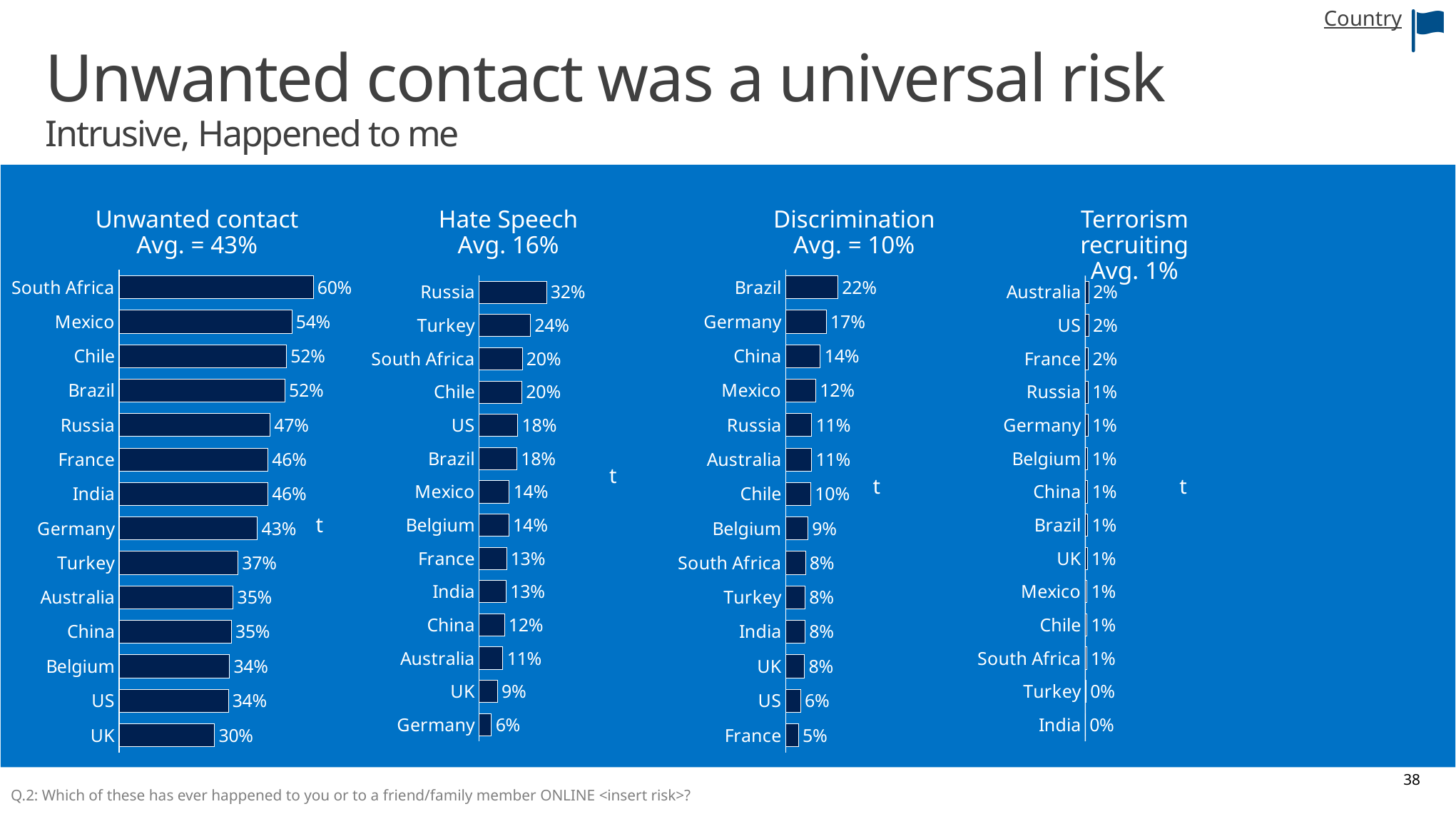
How many countries are shown in the Unwanted contact chart? 14 In the Hate Speech chart, which country has the highest value? Russia In the Discrimination chart, what is the difference between Brazil and China? 8% In the Unwanted contact chart, what is the value for South Africa? 60% In the Unwanted contact chart, which country has the lowest value? UK In the Terrorism recruiting chart, what is the value for Russia? 1% In the Discrimination chart, which country has the lowest value? France In the Hate Speech chart, what is the value for Belgium? 14% In the Hate Speech chart, which is larger, the value for Turkey or the value for US? Turkey In the Unwanted contact chart, what is the difference between Mexico and Germany? 11% In the Discrimination chart, what is the value for Germany? 17% What type of chart is the Hate Speech chart? Bar chart